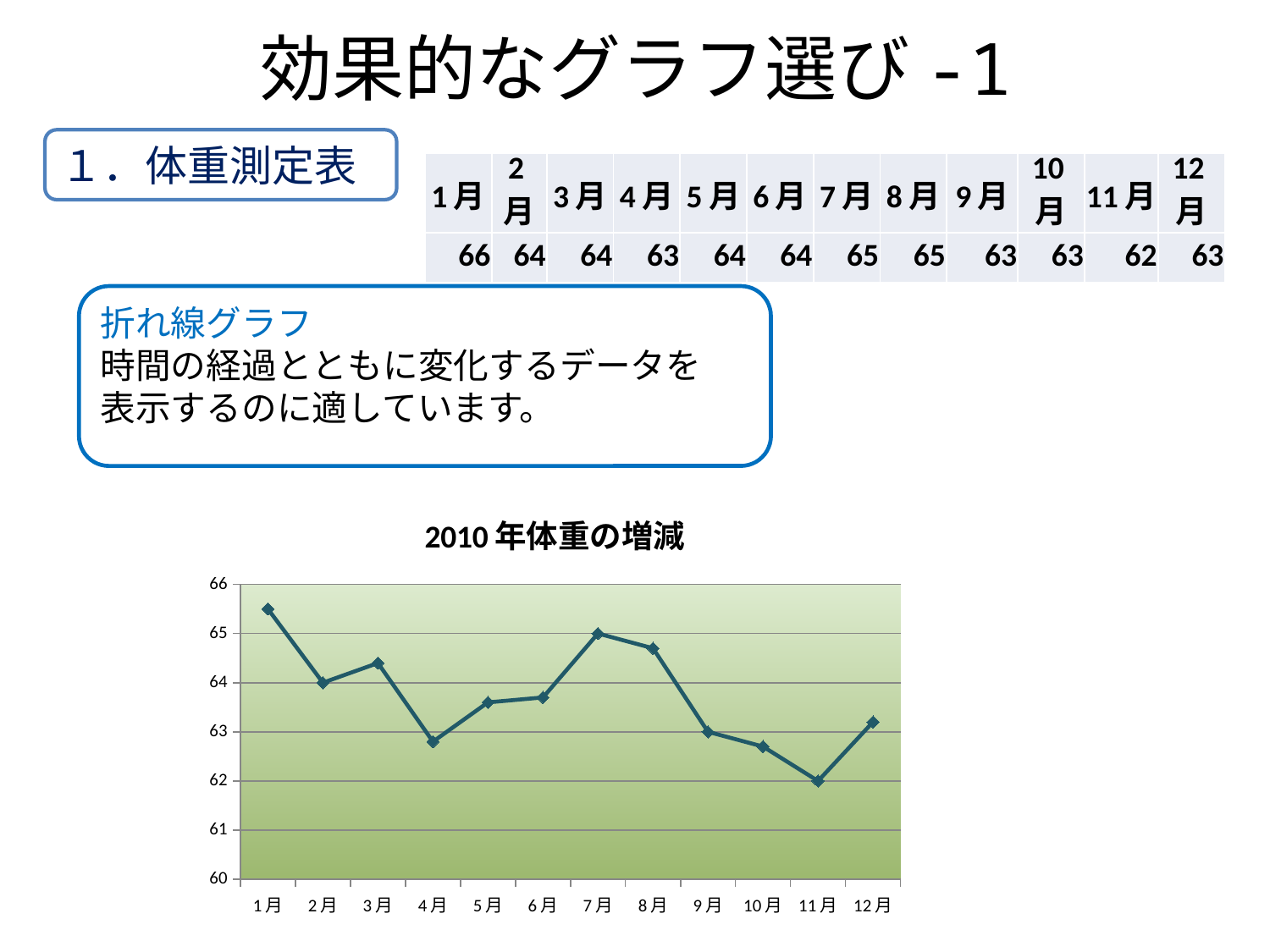
Overall, do the values rise or fall from 1月 to 12月? fall Which month has the highest value in the chart? 1月 Which is larger, the value for 3月 or the value for 4月? 3月 Is the value for 4月 greater or less than 63? less Which month has the lowest value in the chart? 11月 Which is larger, the value for 7月 or the value for 9月? 7月 How many months are plotted on the x axis of the chart? 12 What is the title of the chart? 2010 年体重の増減 Is the value for 1月 greater or less than 65? greater What kind of chart is shown on the slide? line chart Is the value for 8月 greater or less than 64? greater